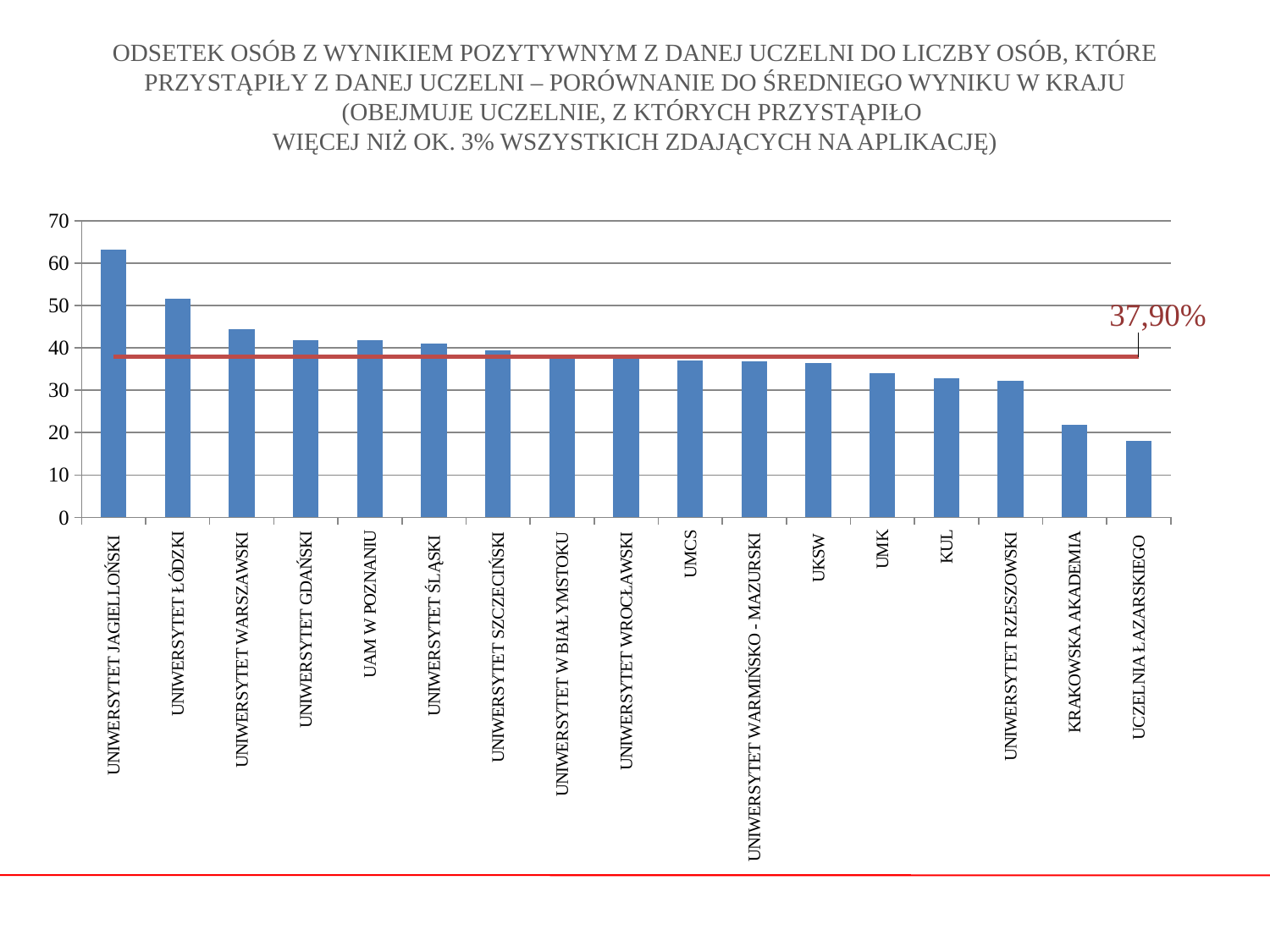
Which university has the lowest bar in the chart? UCZELNIA ŁAZARSKIEGO What value is labelled on the red horizontal line representing the national average? 37,90% Is the value for UNIWERSYTET RZESZOWSKI greater or less than 30? greater Is the value for UCZELNIA ŁAZARSKIEGO greater or less than 20? less What kind of chart is shown on the slide? bar chart Which has the larger value, UNIWERSYTET JAGIELLOŃSKI or UNIWERSYTET ŁÓDZKI? UNIWERSYTET JAGIELLOŃSKI Is the value for UNIWERSYTET JAGIELLOŃSKI greater or less than 60? greater Which university has the highest bar in the chart? UNIWERSYTET JAGIELLOŃSKI How many universities are shown on the x axis of the chart? 17 Which has the larger value, UNIWERSYTET WARSZAWSKI or UMK? UNIWERSYTET WARSZAWSKI Do the bar values generally rise or fall from left to right along the x axis? fall